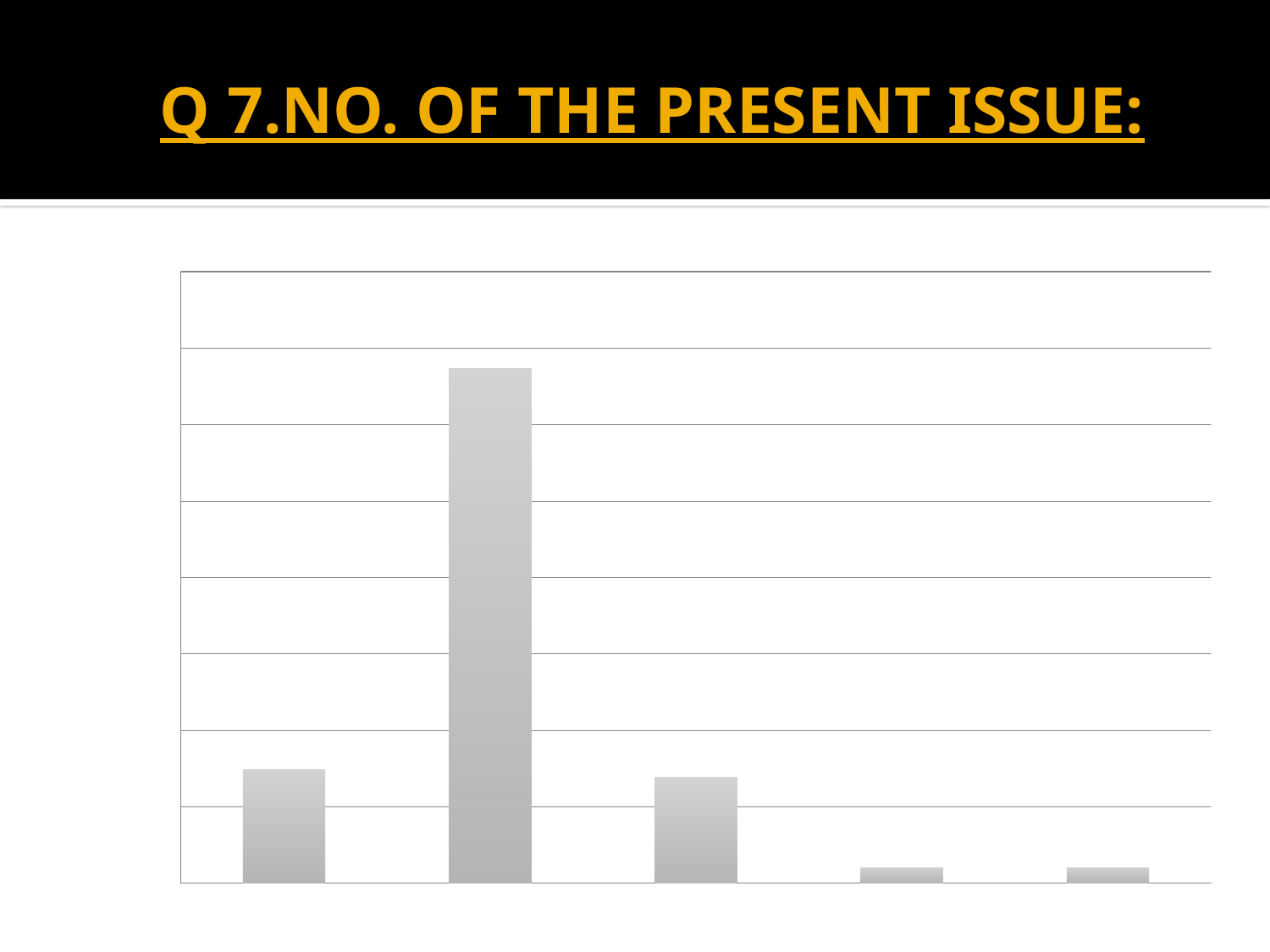
Is the third bar from the left taller or shorter than the second bar from the left? shorter Which bar is the tallest in the chart, counting from the left? the second bar How many bars are plotted in the chart? 5 What colour are the bars in the chart? grey Is the fourth bar from the left taller or shorter than the third bar from the left? shorter Is the second bar from the left taller or shorter than the first bar from the left? taller What kind of chart is shown on the slide? bar chart What is the title of the slide containing the chart? Q 7.NO. OF THE PRESENT ISSUE: